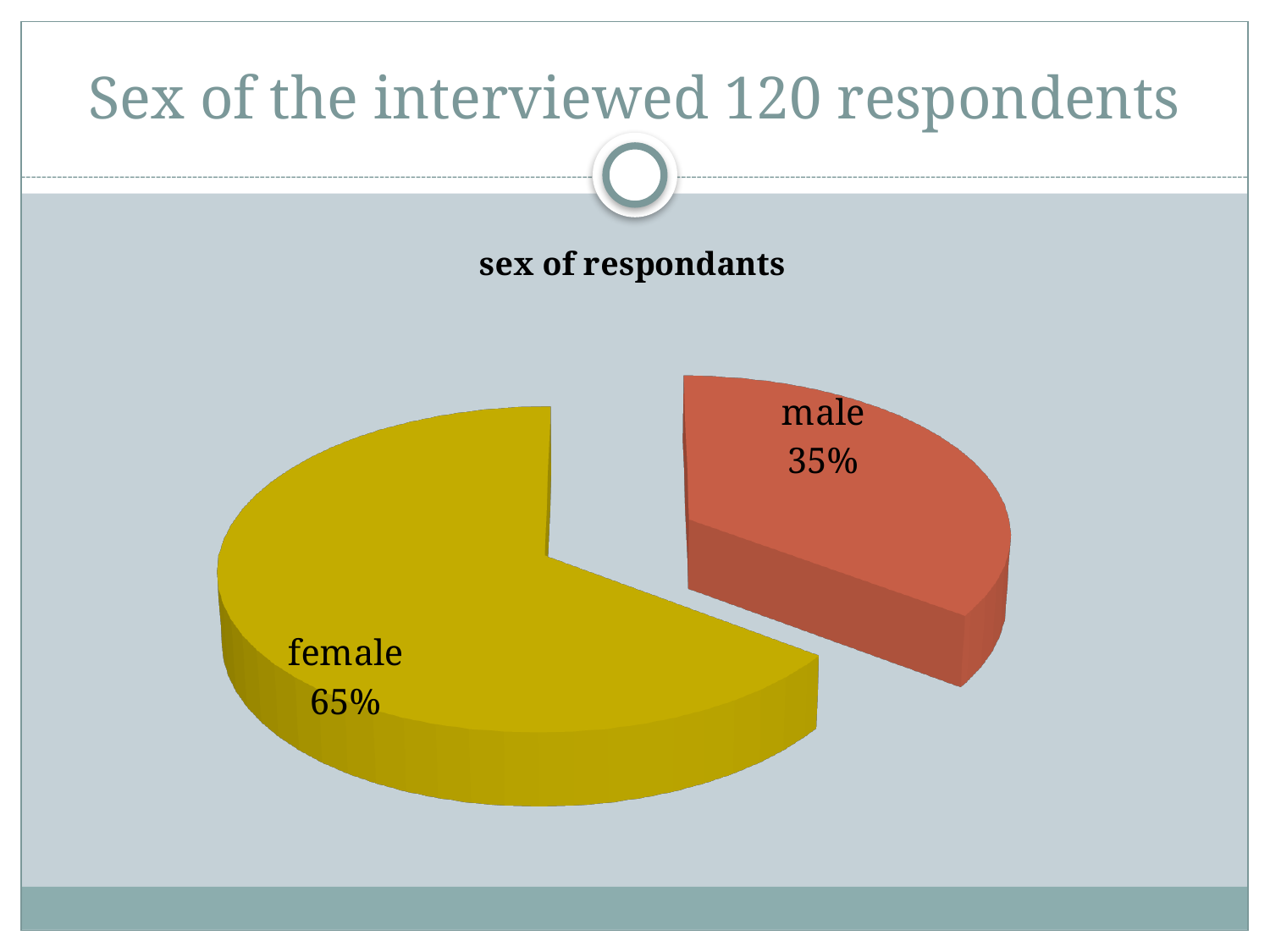
What kind of chart is shown on the slide? pie chart What is the difference in percentage points between the female and male shares? 30 Which category has the largest share of the pie? female What percentage of respondents are female? 65% Which is larger, the female share or the male share? female What is the title of the chart? sex of respondants How many slices does the pie chart have? 2 What share of the pie does the male slice represent? 35% What percentage of respondents are male? 35% Which category has the smallest share of the pie? male What colour is the female slice? yellow